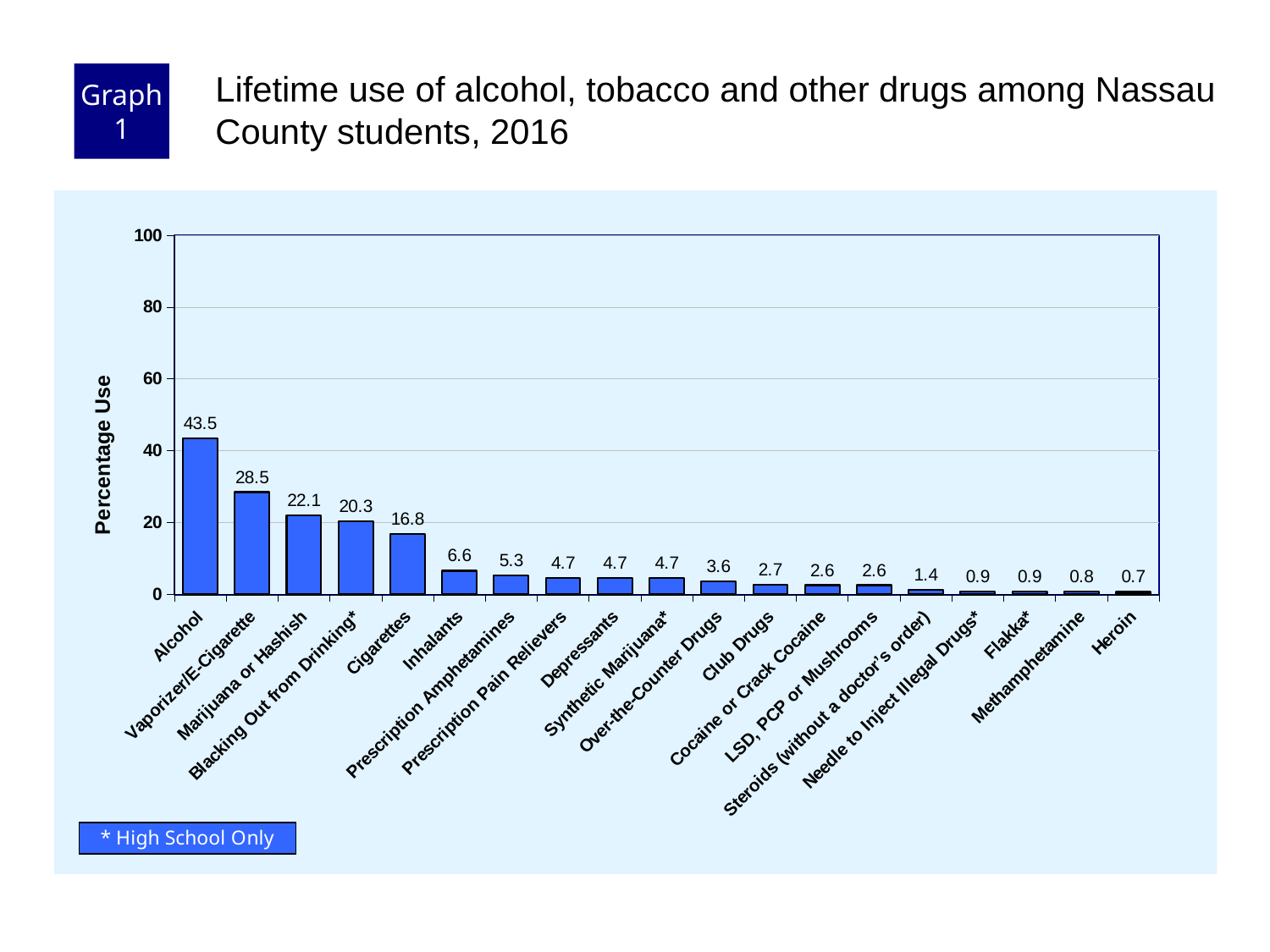
Which category has the lowest percentage use? Heroin What kind of chart is shown on the slide? Bar chart What is the percentage use for Cigarettes? 16.8 What is the percentage use for Alcohol? 43.5 Which category has the highest percentage use? Alcohol What is the difference in percentage use between Alcohol and Vaporizer/E-Cigarette? 15 What is the percentage use for Heroin? 0.7 What is the percentage use for Inhalants? 6.6 What is the label of the y axis? Percentage Use How many categories are shown on the chart? 19 Is the value for Vaporizer/E-Cigarette greater or less than 20? greater Which has a higher percentage use, Marijuana or Hashish or Cigarettes? Marijuana or Hashish